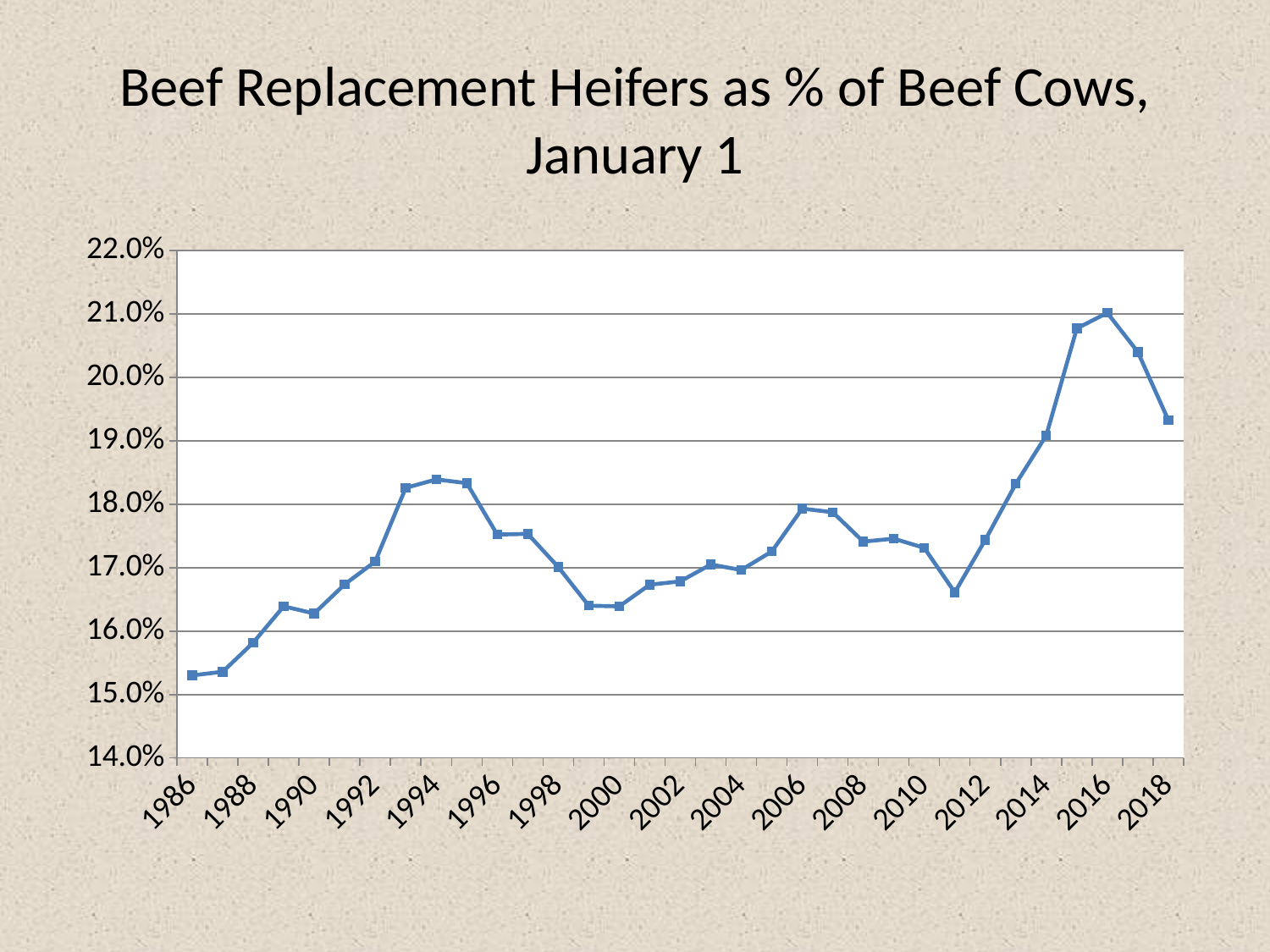
Is the value for 1994 greater or less than 18.0%? greater Is the value for 2011 greater or less than 17.0%? less Which year has the larger value, 2016 or 1994? 2016 Is the value for 1986 greater or less than 16.0%? less Which year has the larger value, 1986 or 2018? 2018 What is the title of the chart? Beef Replacement Heifers as % of Beef Cows, January 1 What kind of chart is shown on the slide? line chart Which year has the lowest value on the chart? 1986 Which year has the highest value on the chart? 2016 Do the values rise or fall from 2011 to 2016? rise Do the values rise or fall from 2016 to 2018? fall